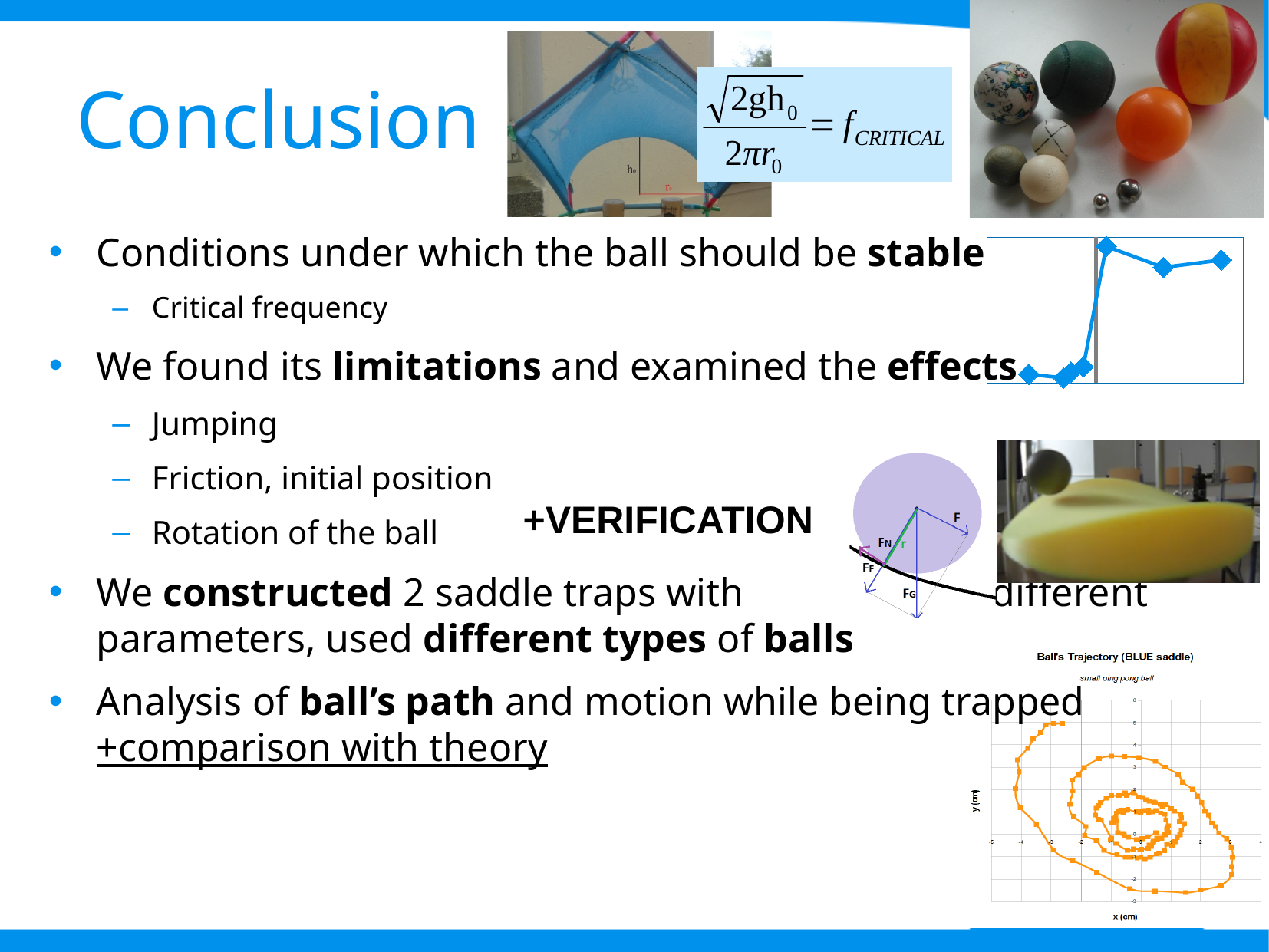
In the chart titled "Ball's Trajectory (BLUE saddle)", what is the label of the x axis? x (cm) What kind of chart is the small chart at the top right of the slide, next to the first bullet point? line chart What is the title of the chart at the bottom right of the slide? Ball's Trajectory (BLUE saddle) What kind of chart is the "Ball's Trajectory (BLUE saddle)" chart? scatter chart In the small line chart at the top right of the slide, do the values rise or fall from left to right along the x axis? rise How many data points are plotted in the small line chart at the top right of the slide? 7